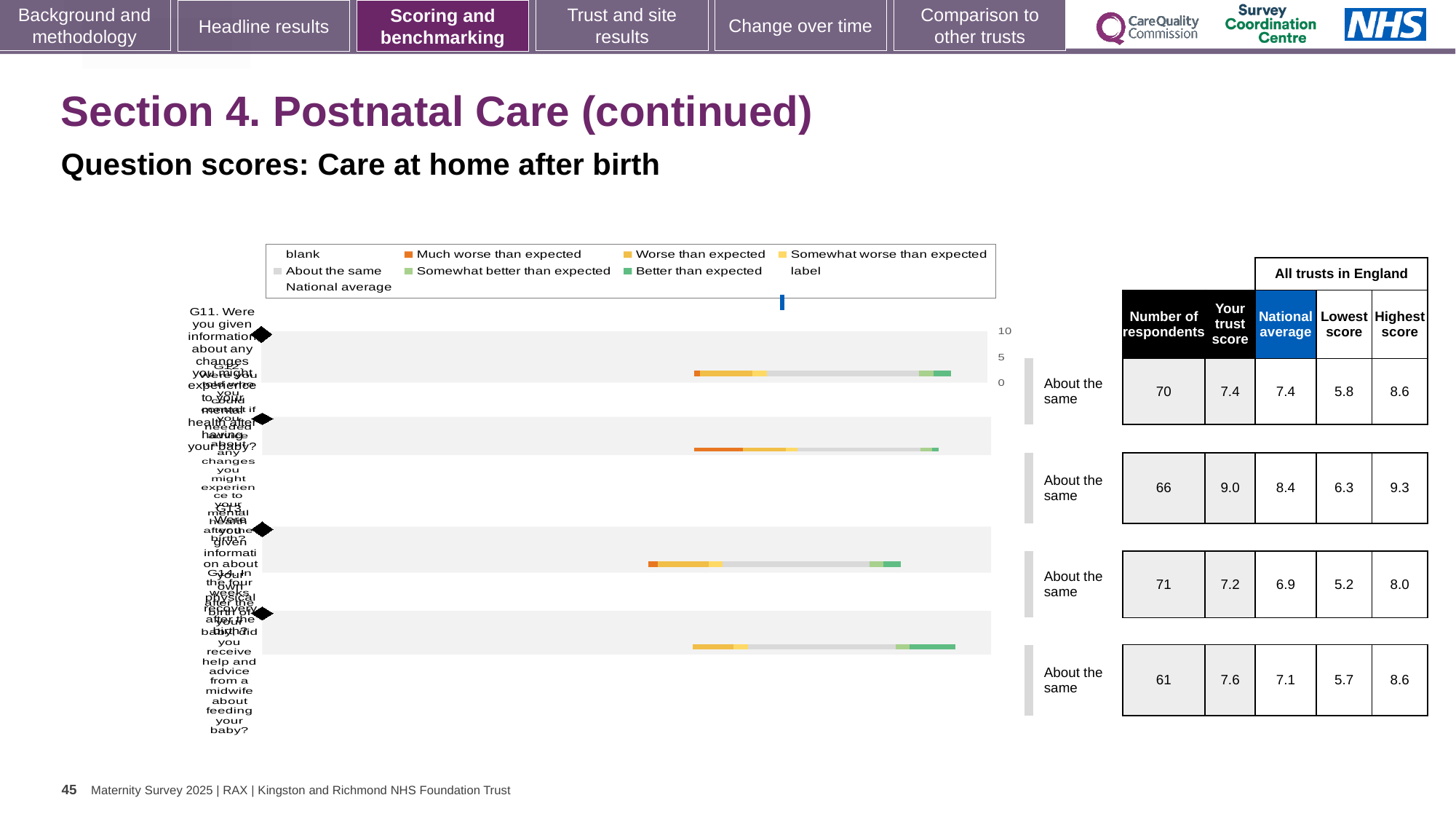
In the table beside the chart, what is the lowest score for the fourth (bottom) question row? 5.7 In the table beside the chart, what is the trust score for the second question row? 9.0 In the table beside the chart, what is the number of respondents for the first (top) question row? 70 Which question row has the highest trust score in the table? The second row (9.0) Which question row has the lowest number of respondents in the table? The fourth row (61) How many question bars are plotted in the chart? 4 In the first question row, is the trust score higher than, lower than, or the same as the national average? The same In the table beside the chart, what is the national average for the third question row? 6.9 What kind of chart is shown on the slide? Horizontal stacked bar chart For the third question row, what is the difference between the highest score and the lowest score? 2.8 For the second question row, how much higher is the trust score than the national average? 0.6 What colour represents 'Much worse than expected' in the chart legend? Orange